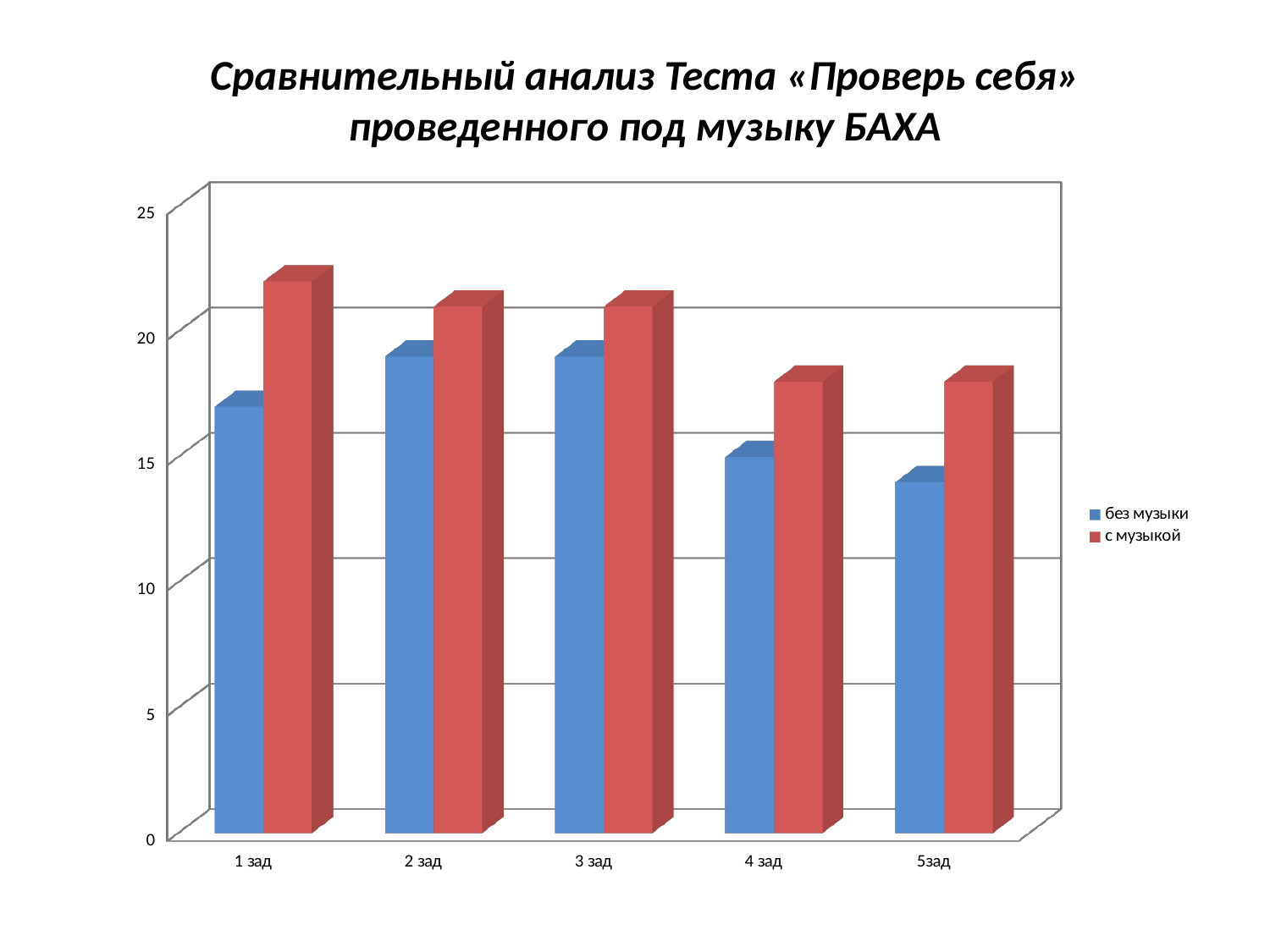
At 5зад, which series has the larger value, 'без музыки' or 'с музыкой'? с музыкой For which task is the 'без музыки' value lowest? 5зад Is the value for 'с музыкой' at 4 зад greater or less than 20? less For which task is the 'с музыкой' value highest? 1 зад What kind of chart is shown on the slide? bar chart What are the two legend entries? без музыки, с музыкой Is the value for 'с музыкой' at 1 зад greater or less than 20? greater Is the value for 'без музыки' at 5зад greater or less than 15? less How many series does the legend list? 2 How many categories (tasks) are shown on the x axis? 5 Which series is shown in red? с музыкой